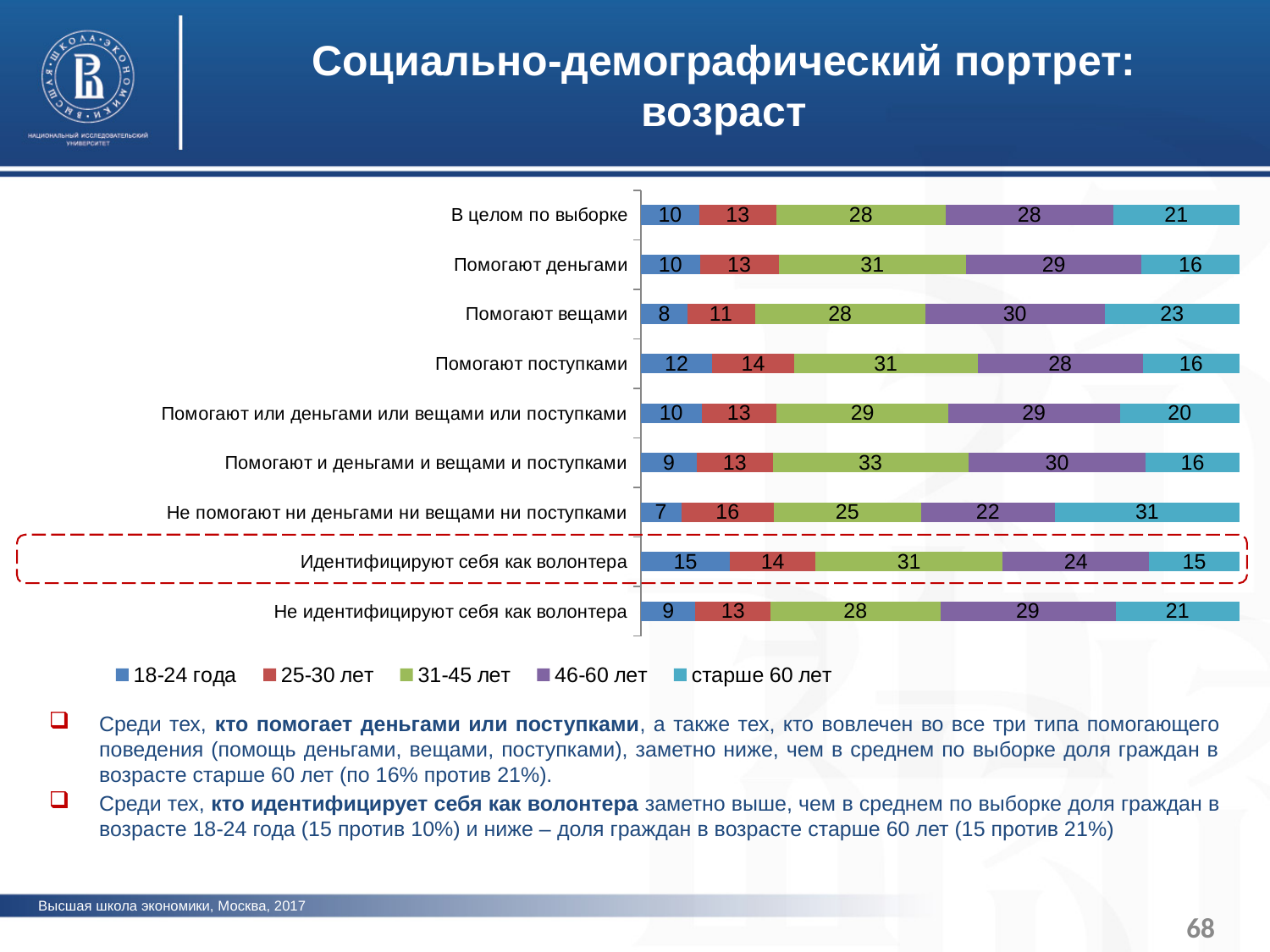
What is the value for the '18-24 года' series in the 'Идентифицируют себя как волонтера' category? 15 How many series does the legend list? 5 What type of chart is shown on the slide? stacked bar chart What is the value for the '31-45 лет' series in the 'Помогают и деньгами и вещами и поступками' category? 33 Which category on the chart is highlighted with a red dashed outline? Идентифицируют себя как волонтера How many categories (bars) are shown in the chart? 9 What is the total of the stacked bar for 'Помогают поступками'? 101 Which category has the lowest value for the '18-24 года' series? Не помогают ни деньгами ни вещами ни поступками What is the value for the 'старше 60 лет' series in the 'Не помогают ни деньгами ни вещами ни поступками' category? 31 Which category has the highest value for the '18-24 года' series? Идентифицируют себя как волонтера Which is larger: the '46-60 лет' value for 'Помогают вещами' or for 'Идентифицируют себя как волонтера'? Помогают вещами What is the difference between the 'старше 60 лет' values for 'В целом по выборке' and 'Помогают деньгами'? 5